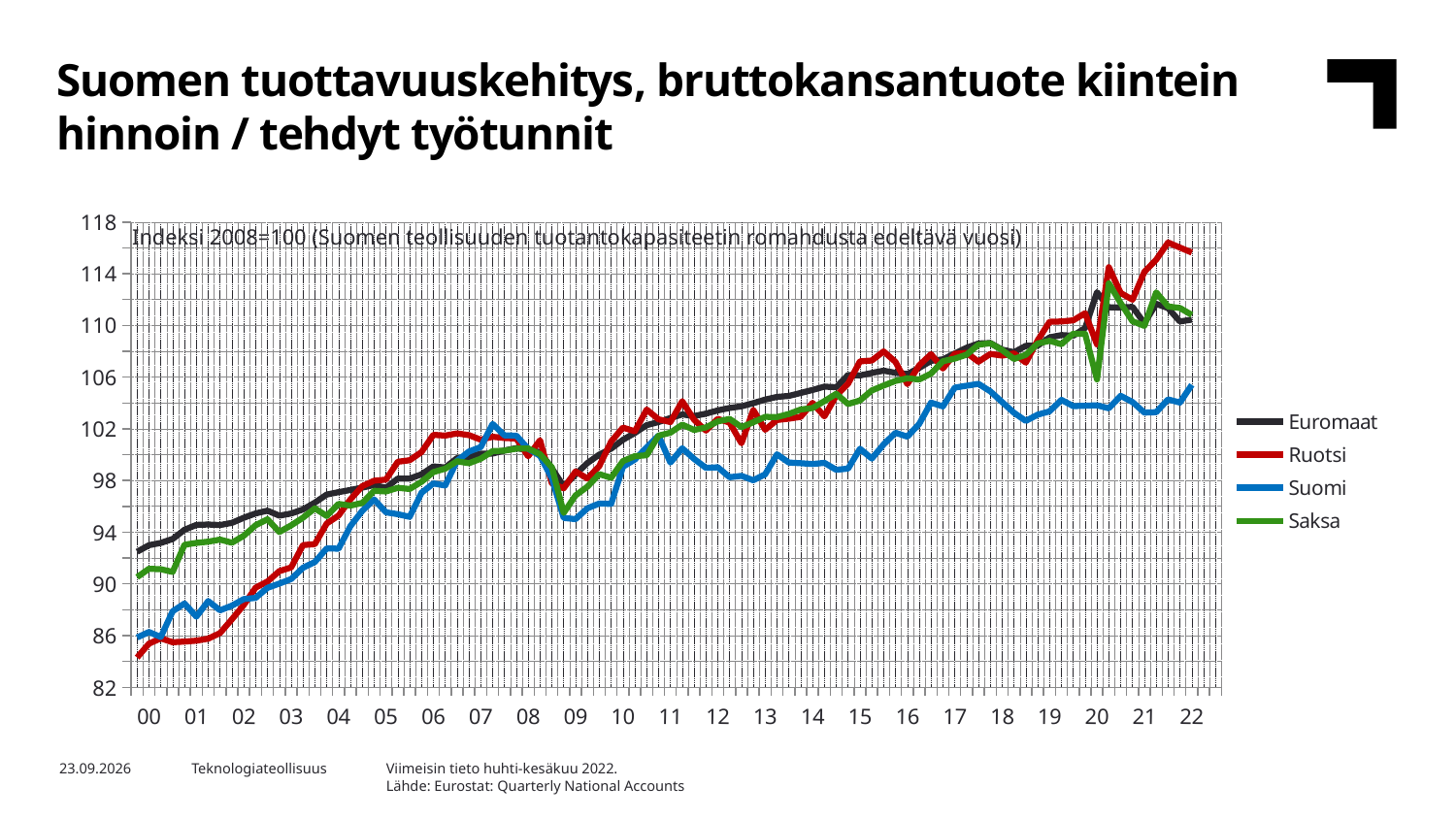
Which series are listed in the legend? Euromaat, Ruotsi, Suomi, Saksa Which year is the index base (=100) according to the chart? 2008 Is the value for Suomi at the end of 2022 greater or less than 110? less Which series has the highest value at the end of the chart (2022)? Ruotsi At the end of the chart (2022), which is higher, Ruotsi or Suomi? Ruotsi Is the value for Ruotsi at the end of 2022 greater or less than 110? greater Does the Suomi series rise or fall between 2000 and 2008? rise Which series has the lowest value at the end of the chart (2022)? Suomi How many series does the legend list? 4 Is the value for Suomi at the start of 2000 greater or less than 90? less What kind of chart is shown on the slide? line chart How many year labels are shown on the x axis? 23